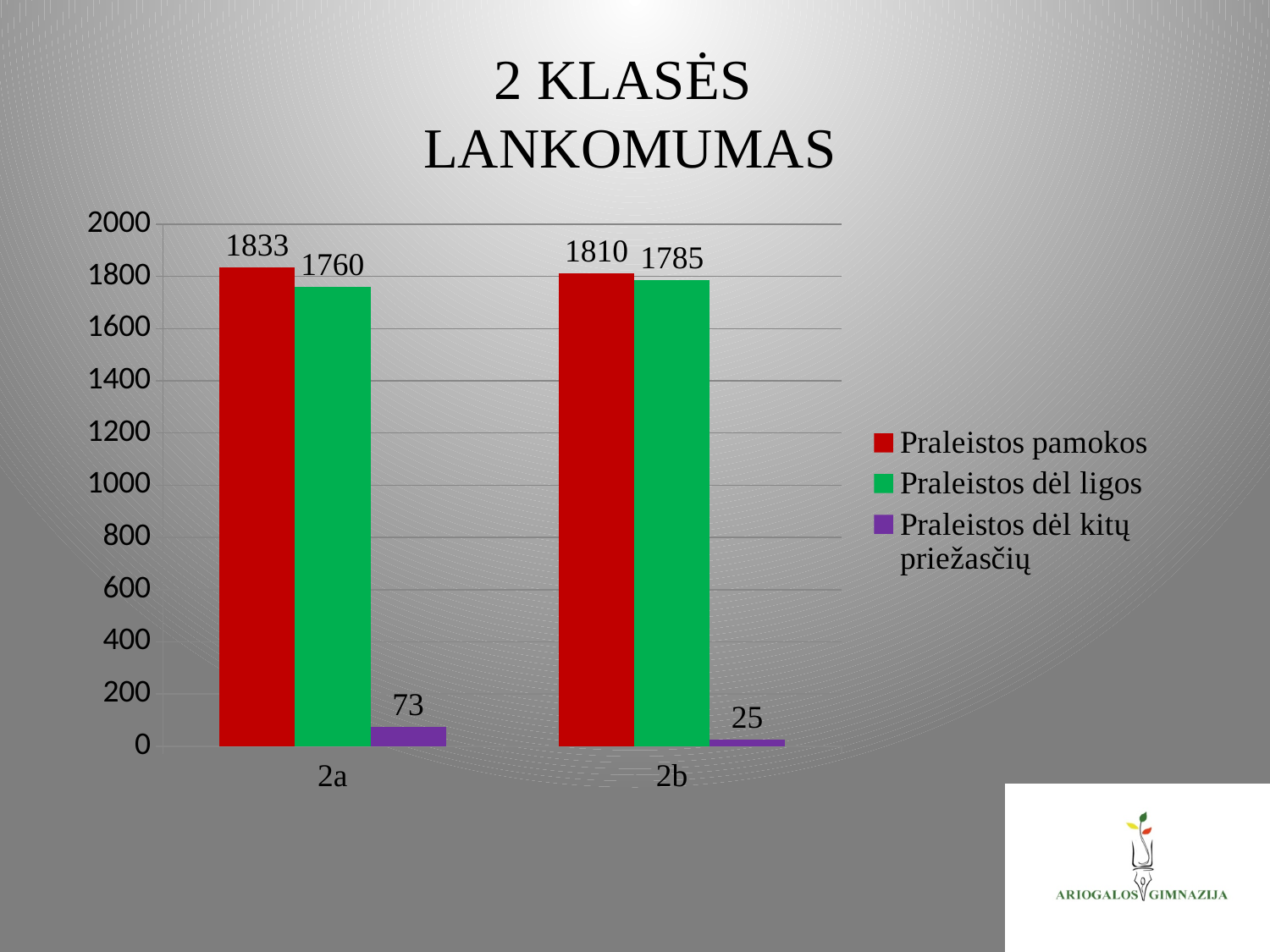
Which class has the higher value for Praleistos pamokos, 2a or 2b? 2a What is the value of Praleistos dėl kitų priežasčių for 2b? 25 What is the value of Praleistos dėl ligos for 2b? 1785 What is the difference between Praleistos pamokos and Praleistos dėl ligos for 2a? 73 What is the value of Praleistos pamokos for 2a? 1833 What type of chart is shown on the slide? bar chart Which class has the lower value for Praleistos dėl kitų priežasčių? 2b What is the difference between Praleistos dėl kitų priežasčių for 2a and 2b? 48 How many series does the legend list? 3 How many classes are shown on the x axis? 2 What is the value of Praleistos dėl kitų priežasčių for 2a? 73 Is the value of Praleistos dėl ligos for 2a greater or less than 1800? less